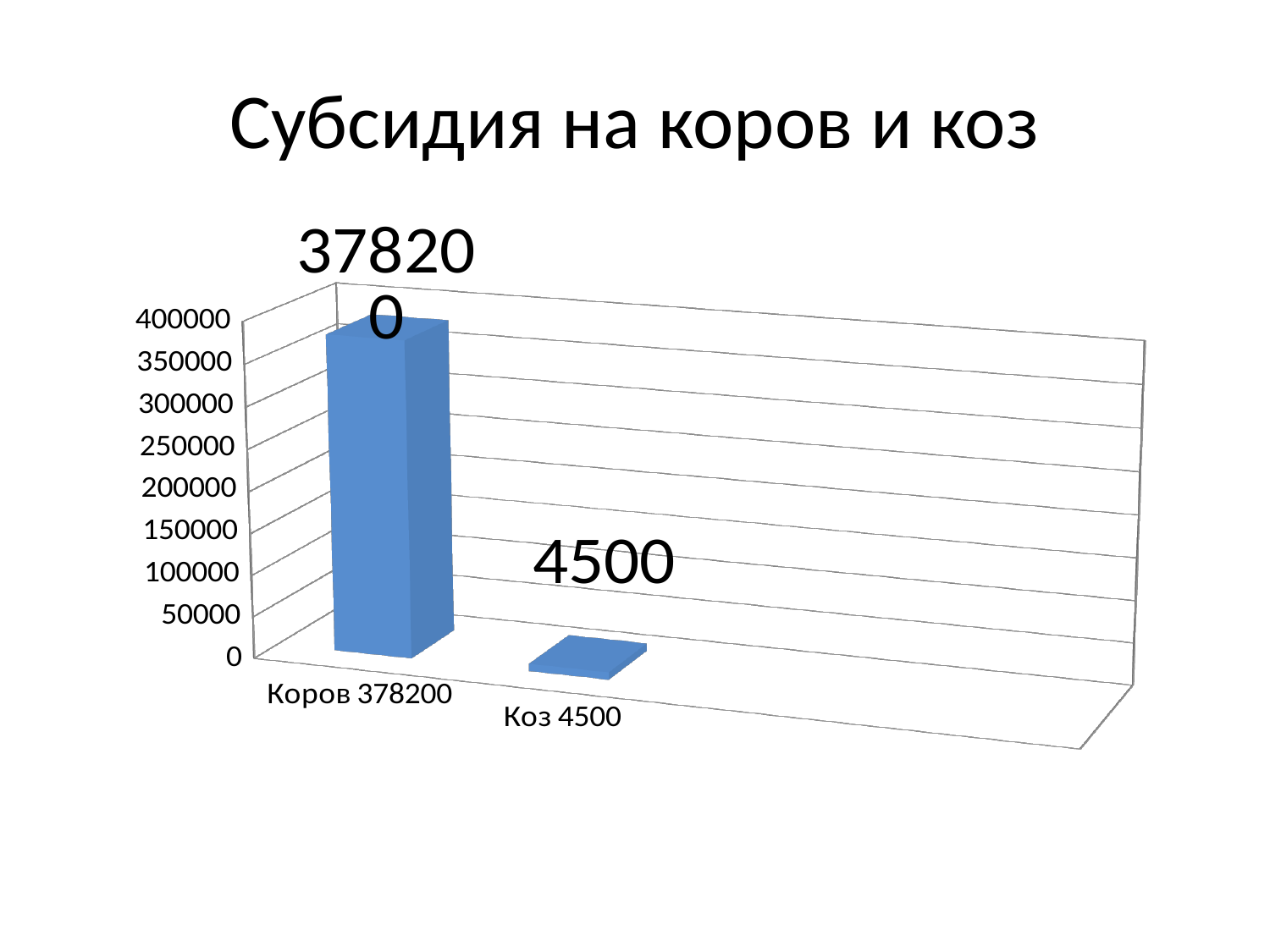
Is the value for Коров greater or less than 350000? greater How many categories are shown in the chart? 2 Which category has the highest value? Коров Which category has the lowest value? Коз Is the value for Коз greater or less than 50000? less What is the title of the slide? Субсидия на коров и коз What is the value for Коров? 378200 Which is larger, the value for Коров or the value for Коз? Коров What is the value for Коз? 4500 What is the maximum value shown on the vertical axis? 400000 What kind of chart is shown on the slide? bar chart What is the difference between the values for Коров and Коз? 373700